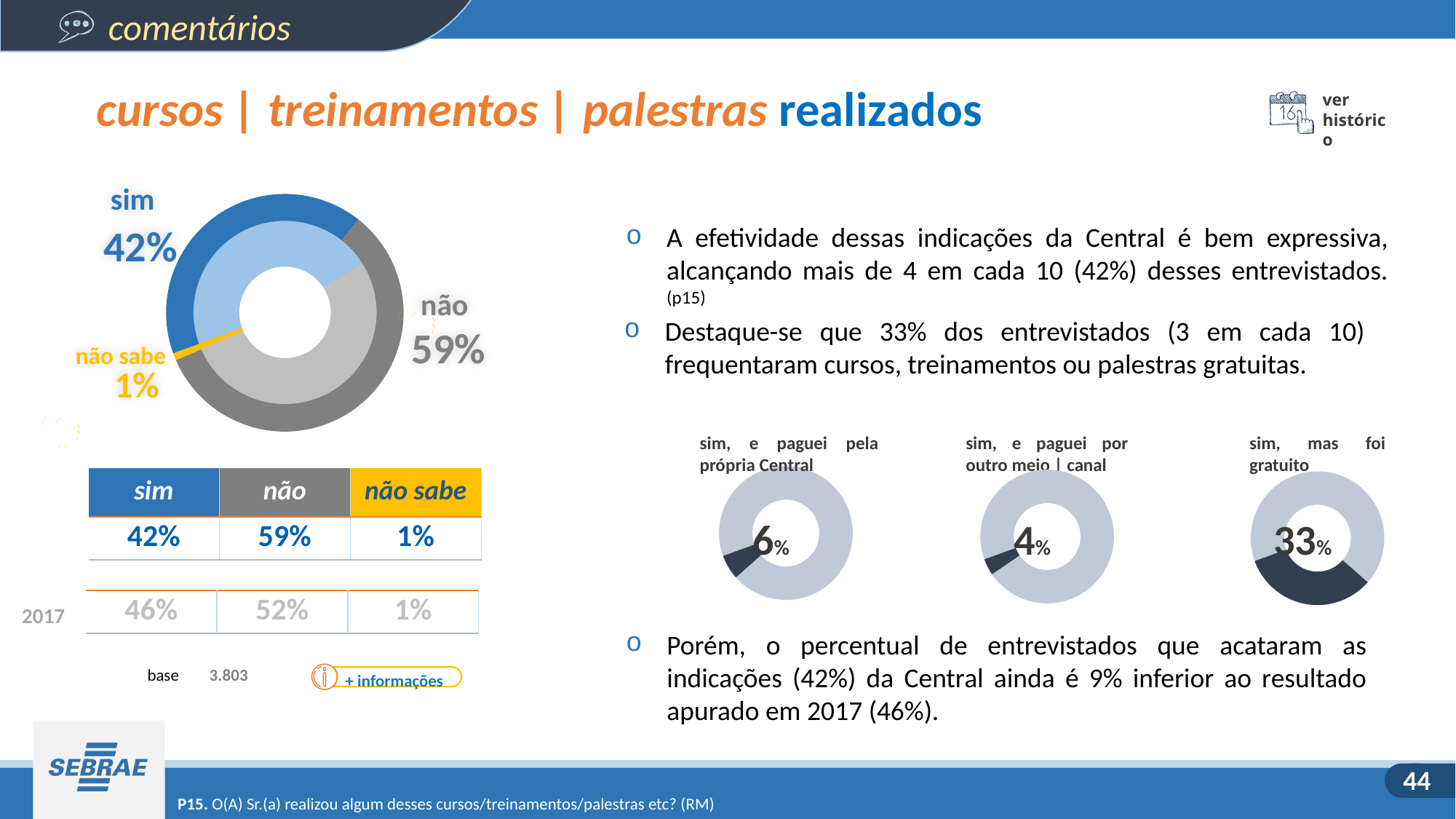
In the large donut chart on the left, what is the value for "não"? 59% What kind of chart is the large chart on the left of the slide? Donut (pie) chart In the large donut chart on the left, what is the difference between the values for "não" and "sim"? 17% In the large donut chart on the left, which is larger, "sim" or "não"? não In the large donut chart on the left, which category has the lowest value? não sabe In the small donut chart titled "sim, e paguei por outro meio | canal", what value is shown? 4% Among the three small donut charts on the right, which one shows the highest value? sim, mas foi gratuito In the large donut chart on the left, what is the value for "sim"? 42% How many categories does the large donut chart on the left show? 3 In the large donut chart on the left, which category has the highest value? não In the small donut chart titled "sim, e paguei pela própria Central", what value is shown? 6% In the large donut chart on the left, what is the value for "não sabe"? 1%